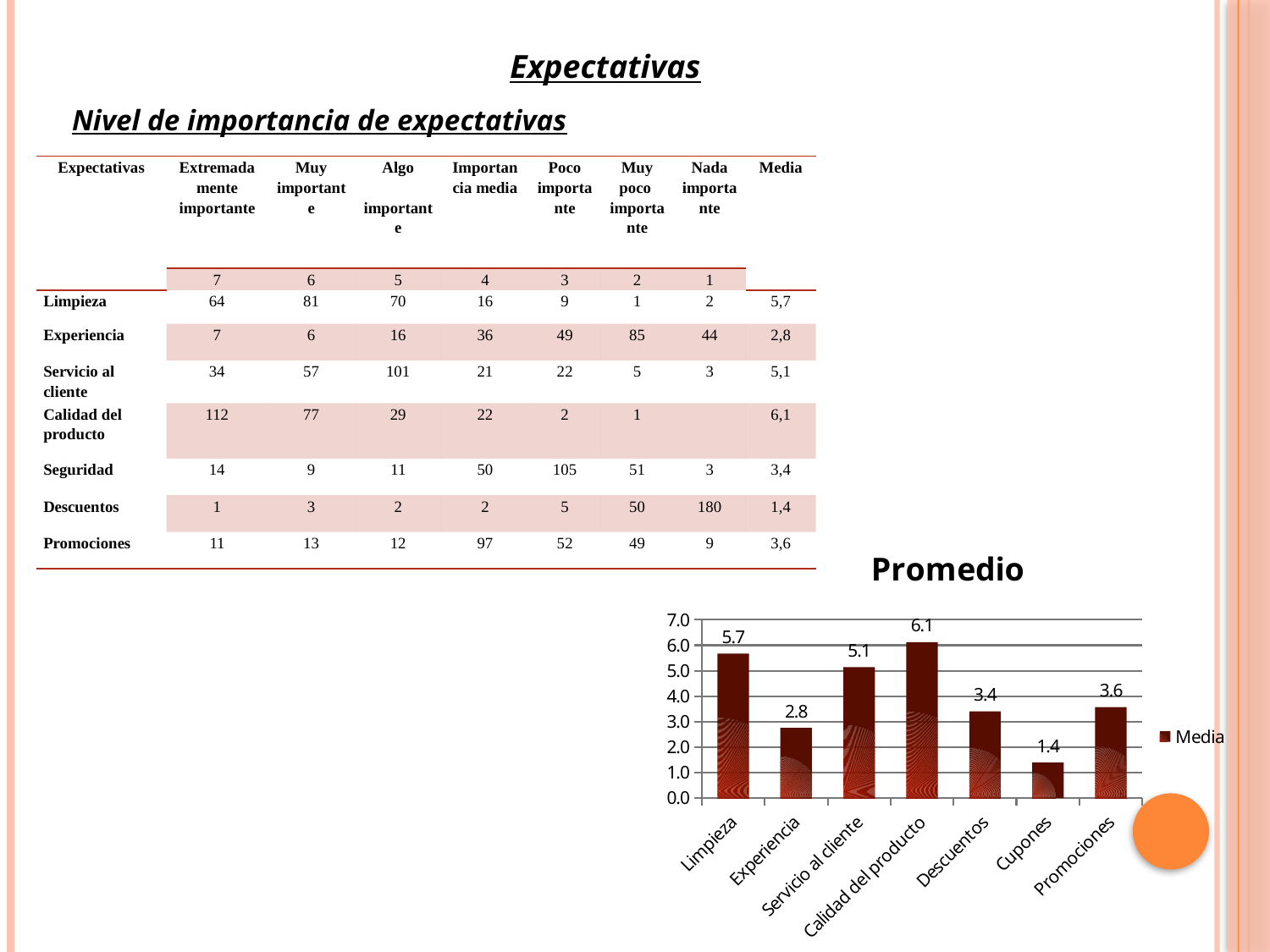
How many categories are shown in the Promedio chart? 7 In the Promedio chart, which category has the highest value? Calidad del producto In the Promedio chart, what is the difference between the values for Calidad del producto and Experiencia? 3.3 In the Promedio chart, what is the value for Calidad del producto? 6.1 How many series does the legend of the Promedio chart list? 1 In the Promedio chart, what is the value for Cupones? 1.4 What kind of chart is the Promedio chart? bar chart In the Promedio chart, what is the value for Limpieza? 5.7 What is the name of the series shown in the legend of the Promedio chart? Media In the Promedio chart, which is larger, the value for Descuentos or the value for Promociones? Promociones In the Promedio chart, which category has the lowest value? Cupones In the Promedio chart, is the value for Servicio al cliente greater or less than 4.0? greater